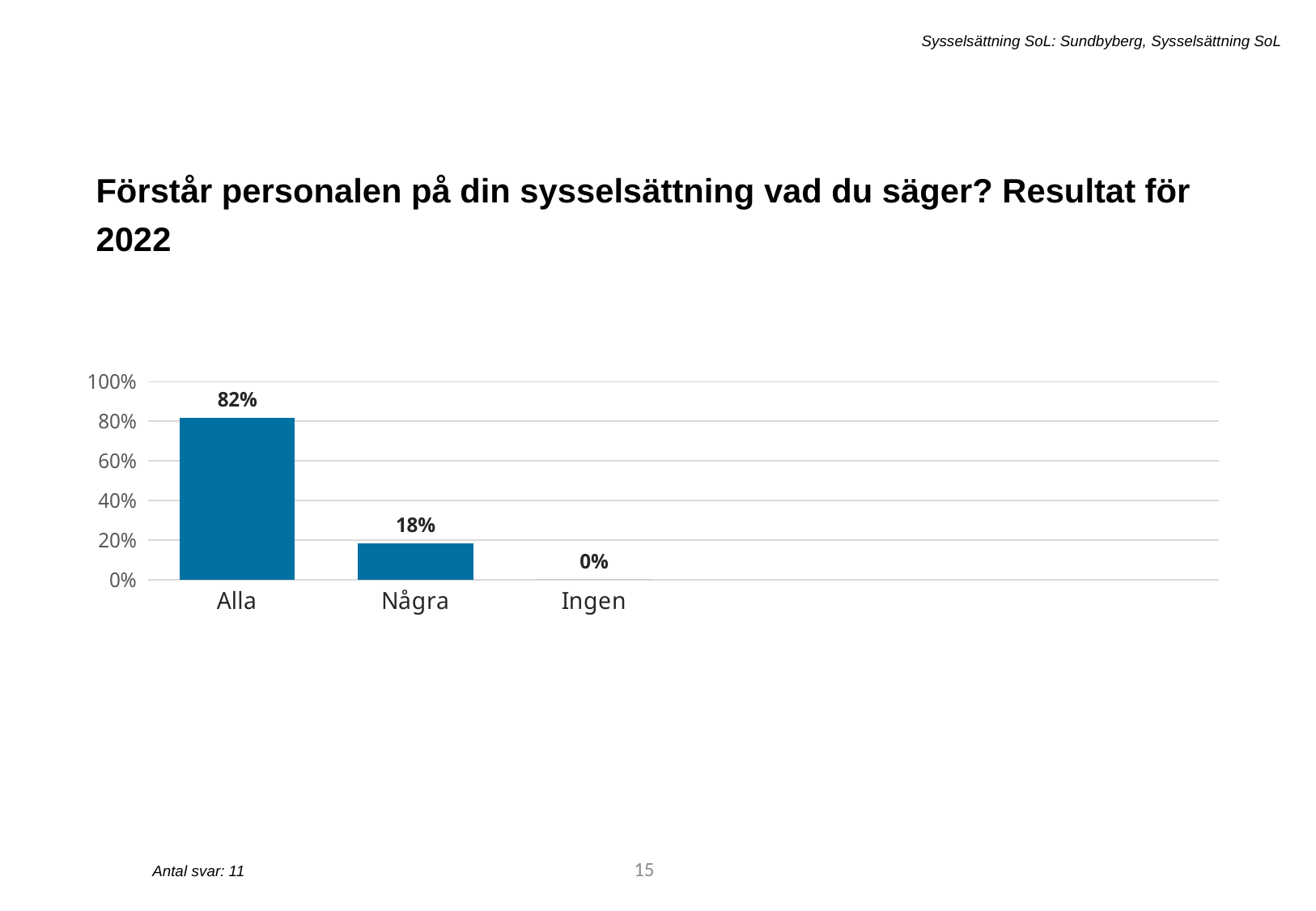
What is the value for Ingen? 0% Do the values rise or fall from left to right along the x axis? fall Is the value for Några greater or less than 40%? less Is the value for Alla greater or less than 60%? greater What is the difference between the values for Alla and Några? 64% What is the value for Alla? 82% Which is larger, the value for Några or the value for Ingen? Några What is the value for Några? 18% How many categories are shown on the x axis? 3 What kind of chart is shown on the slide? bar chart Which category has the highest value? Alla Which category has the lowest value? Ingen